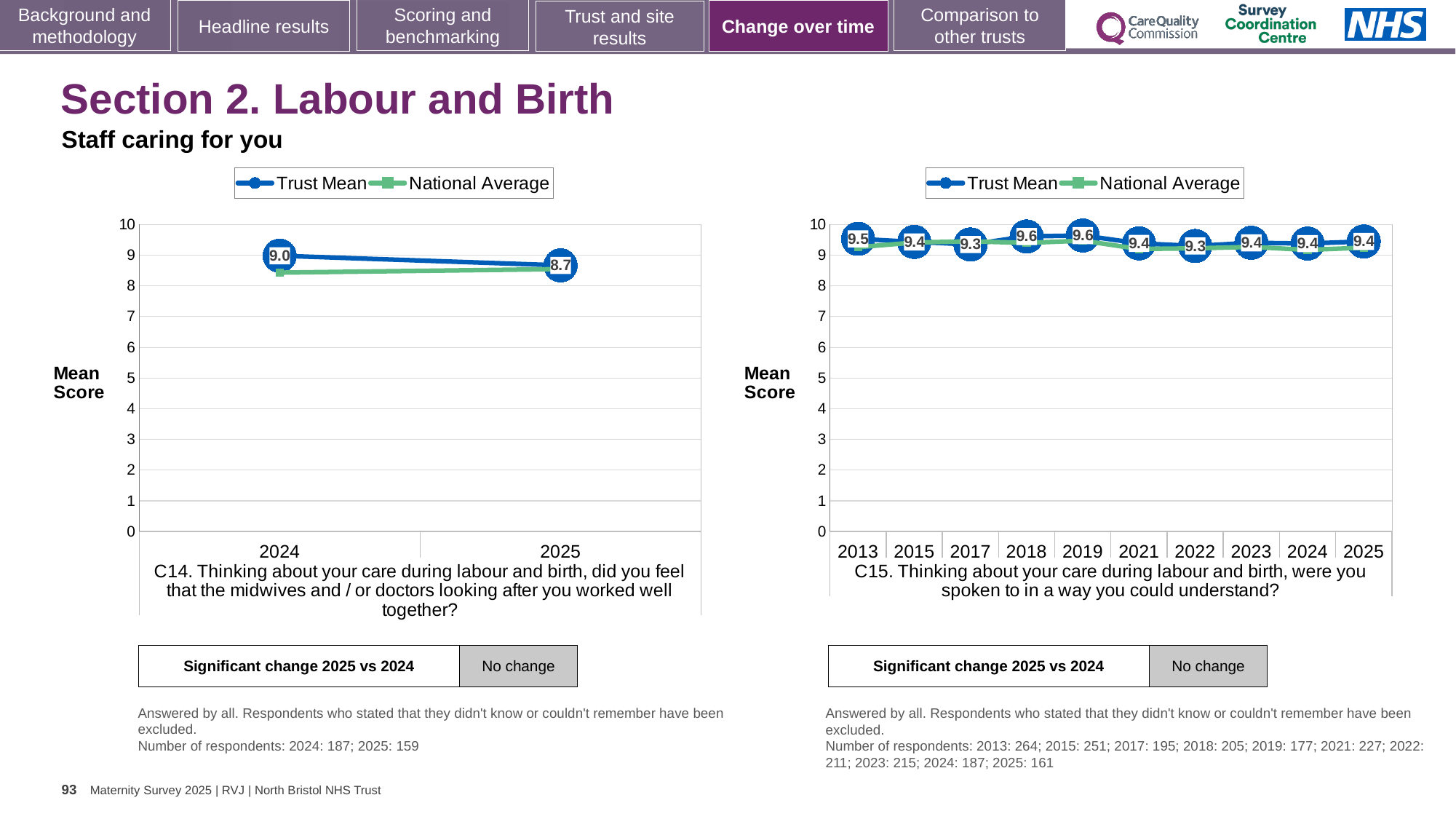
In the right chart (C15), what is the Trust Mean value for 2018? 9.6 In the left chart (C14), what is the Trust Mean value for 2024? 9.0 In the left chart (C14), which year has the higher Trust Mean, 2024 or 2025? 2024 How many years are shown on the x axis of the right chart (C15)? 10 In the left chart (C14), what is the difference between the Trust Mean for 2024 and 2025? 0.3 In the left chart (C14), is the National Average value for 2024 greater or less than 8? greater What kind of chart is the right chart (C15)? Line chart In the right chart (C15), what is the Trust Mean value for 2025? 9.4 How many series does the legend of the left chart (C14) list? 2 In the left chart (C14), does the Trust Mean rise or fall from 2024 to 2025? Fall In the left chart (C14), what is the Trust Mean value for 2025? 8.7 In the right chart (C15), what is the Trust Mean value for 2022? 9.3